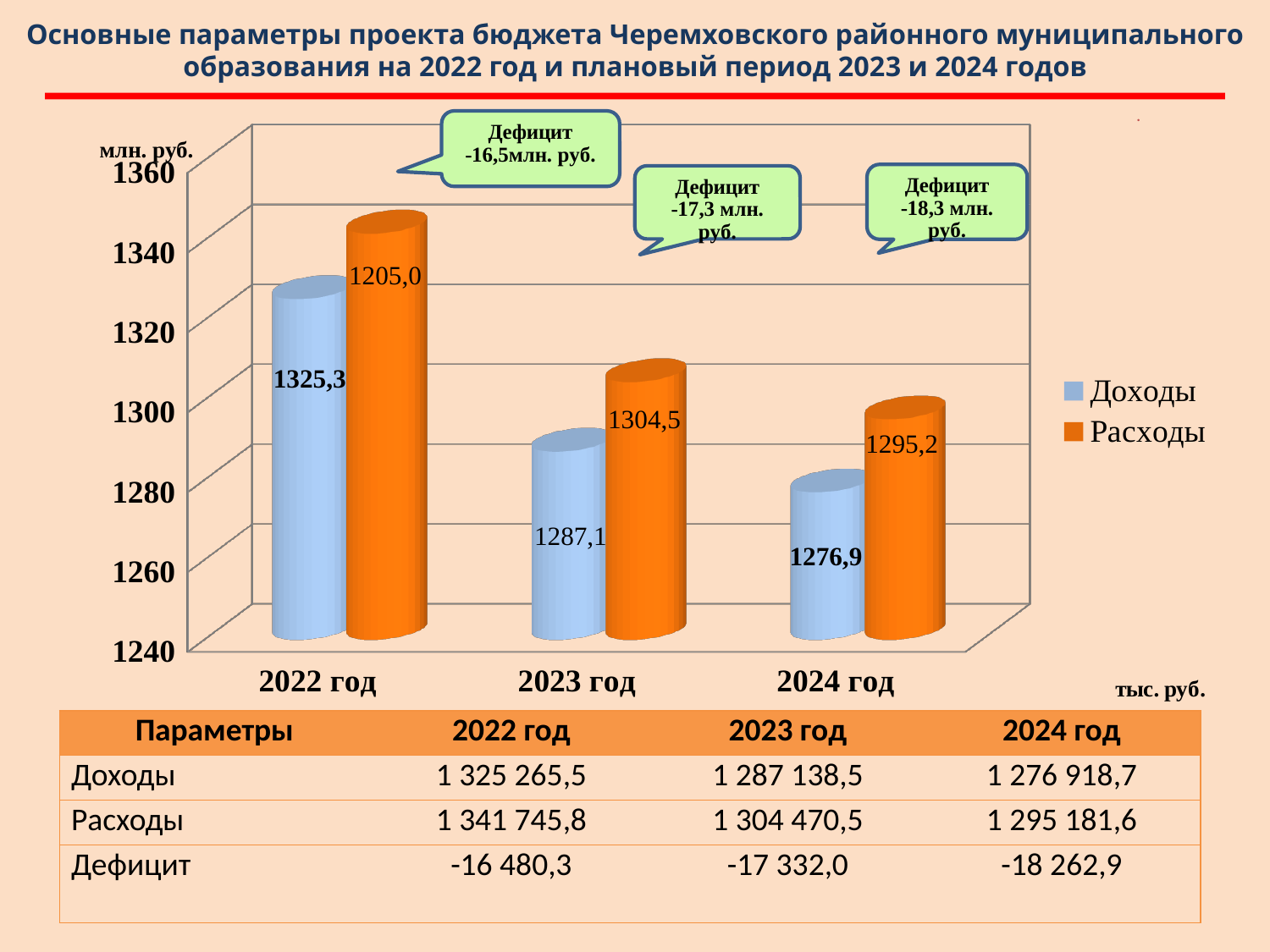
How many years are shown on the x axis of the chart? 3 Which year has the highest value of Доходы? 2022 год Is the value of Расходы for 2022 год greater or less than 1320? greater Which year has the lowest value of Доходы? 2024 год Do the values of Доходы rise or fall from 2022 год to 2024 год? fall What is the value of Расходы for 2024 год? 1295,2 How many series does the chart legend list? 2 What is the value of Расходы for 2023 год? 1304,5 What is the value of Доходы for 2022 год? 1325,3 For 2024 год, which is larger: Доходы or Расходы? Расходы What is the value of Доходы for 2024 год? 1276,9 What is the difference between Расходы and Доходы for 2023 год? 17,4